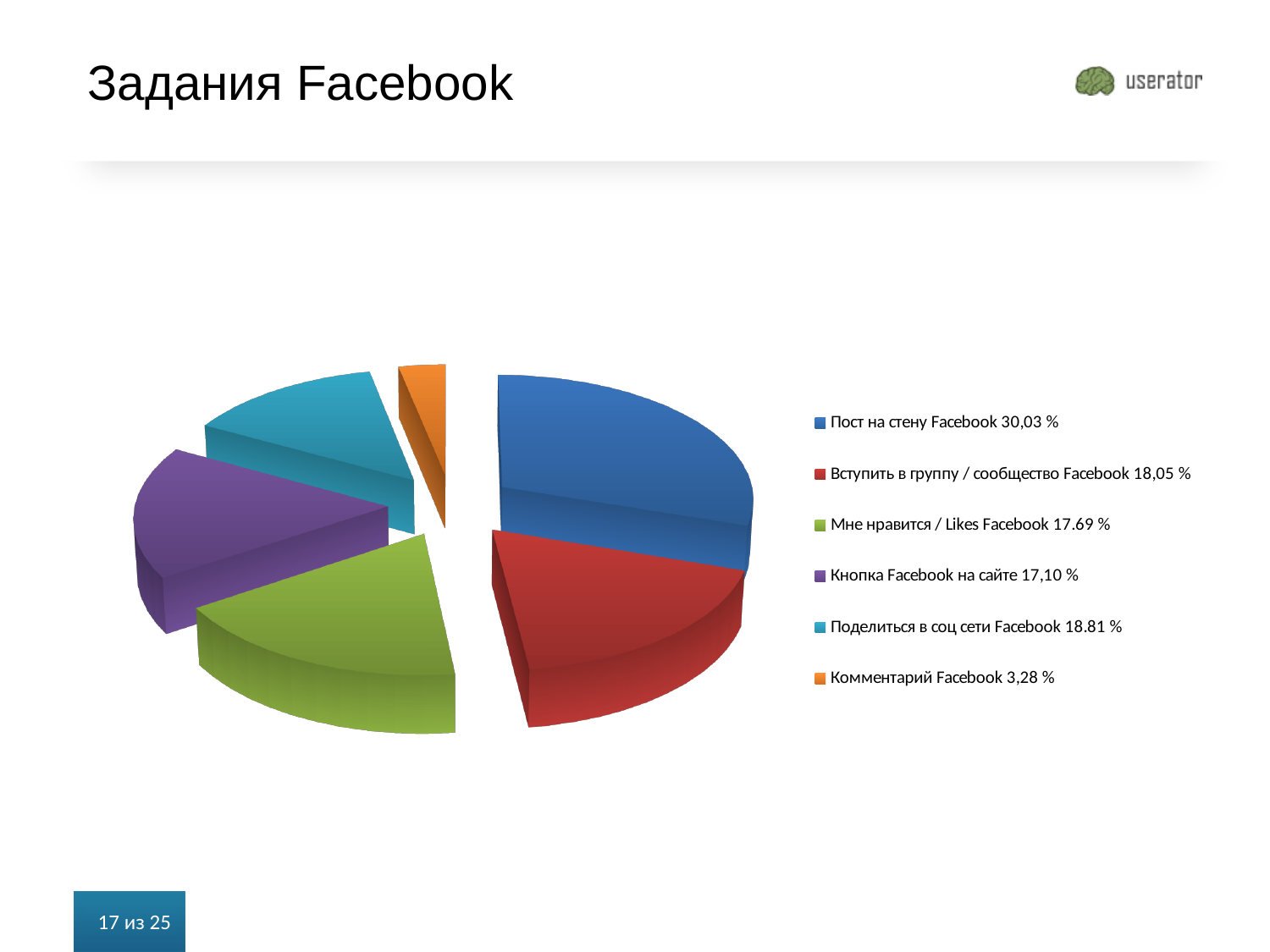
What share does "Комментарий Facebook" have in the pie chart? 3,28 % What share does "Кнопка Facebook на сайте" have in the pie chart? 17,10 % Which category has the smallest share in the pie chart? Комментарий Facebook Which category has the largest share in the pie chart? Пост на стену Facebook What is the difference in percentage points between "Пост на стену Facebook" and "Вступить в группу / сообщество Facebook"? 11,98 What colour is the slice for "Мне нравится / Likes Facebook"? Green What share does "Поделиться в соц сети Facebook" have in the pie chart? 18.81 % What kind of chart is shown on the slide? Pie chart Which has the larger share: "Вступить в группу / сообщество Facebook" or "Кнопка Facebook на сайте"? Вступить в группу / сообщество Facebook What is the difference in percentage points between "Поделиться в соц сети Facebook" and "Мне нравится / Likes Facebook"? 1.12 How many slices does the pie chart have? 6 What share does "Пост на стену Facebook" have in the pie chart? 30,03 %